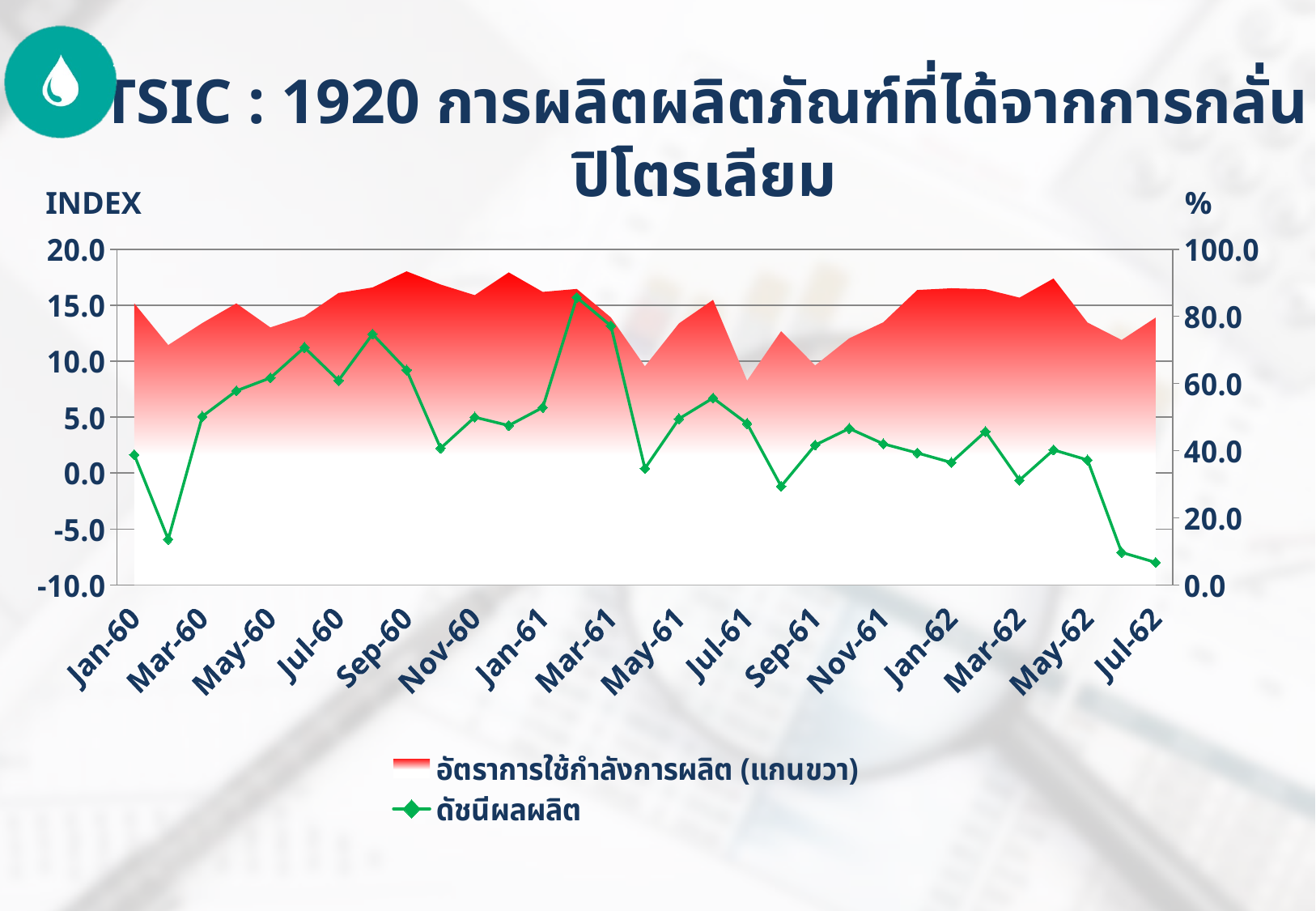
What is the label of the left vertical axis? INDEX Is the value of ดัชนีผลผลิต (green line) for Jul-62 greater or less than -5.0? less Does the ดัชนีผลผลิต (green line) rise or fall from Jan-62 to Jul-62? fall Which series is plotted on the right axis according to the legend? อัตราการใช้กำลังการผลิต (แกนขวา) At which month does the ดัชนีผลผลิต (green line) reach its highest point? Feb-61 Is the value of อัตราการใช้กำลังการผลิต (red area, right axis) for Sep-60 greater or less than 80.0? greater Is the value of ดัชนีผลผลิต (green line) for Mar-60 greater or less than 0.0? greater How many series does the legend list? 2 What kind of chart is shown on the slide? A combination chart with a shaded area series and a line series